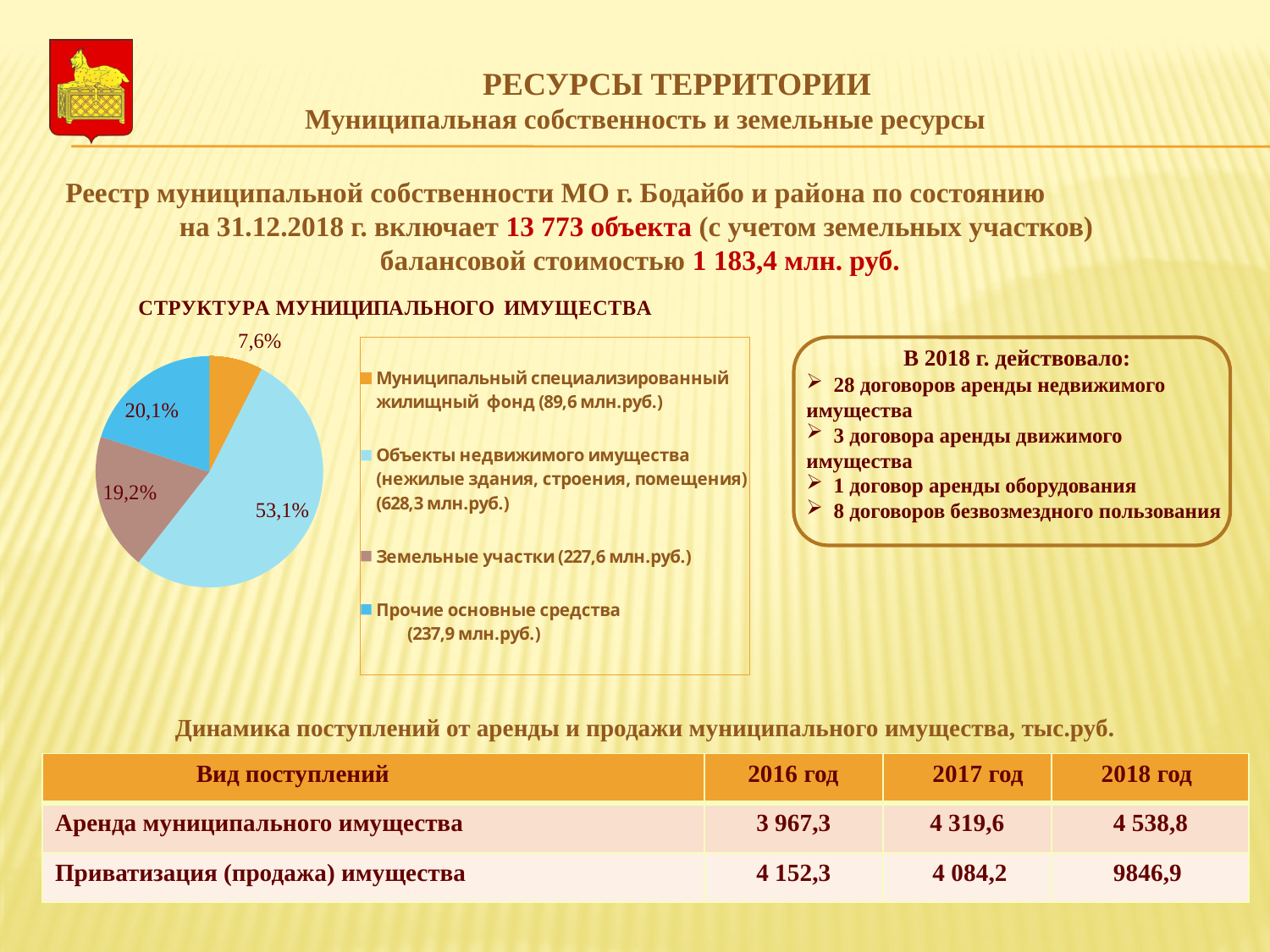
In the pie chart, which slice is larger: «Земельные участки» or «Прочие основные средства»? Прочие основные средства According to the pie chart legend, what is the value in млн.руб. for «Земельные участки»? 227,6 млн.руб. In the pie chart, what share is shown for «Муниципальный специализированный жилищный фонд»? 7,6% What kind of chart is shown under the heading «СТРУКТУРА МУНИЦИПАЛЬНОГО ИМУЩЕСТВА»? Pie chart In the pie chart, what share is shown for «Земельные участки»? 19,2% How many slices does the pie chart have? 4 In the pie chart, what share is shown for «Прочие основные средства»? 20,1% What is the difference in percentage points between the «Объекты недвижимого имущества» slice and the «Земельные участки» slice? 33,9 Which category has the smallest slice in the pie chart? Муниципальный специализированный жилищный фонд In the pie chart, what share is shown for «Объекты недвижимого имущества»? 53,1% Which category has the largest slice in the pie chart? Объекты недвижимого имущества What colour is the «Муниципальный специализированный жилищный фонд» slice in the pie chart? Orange